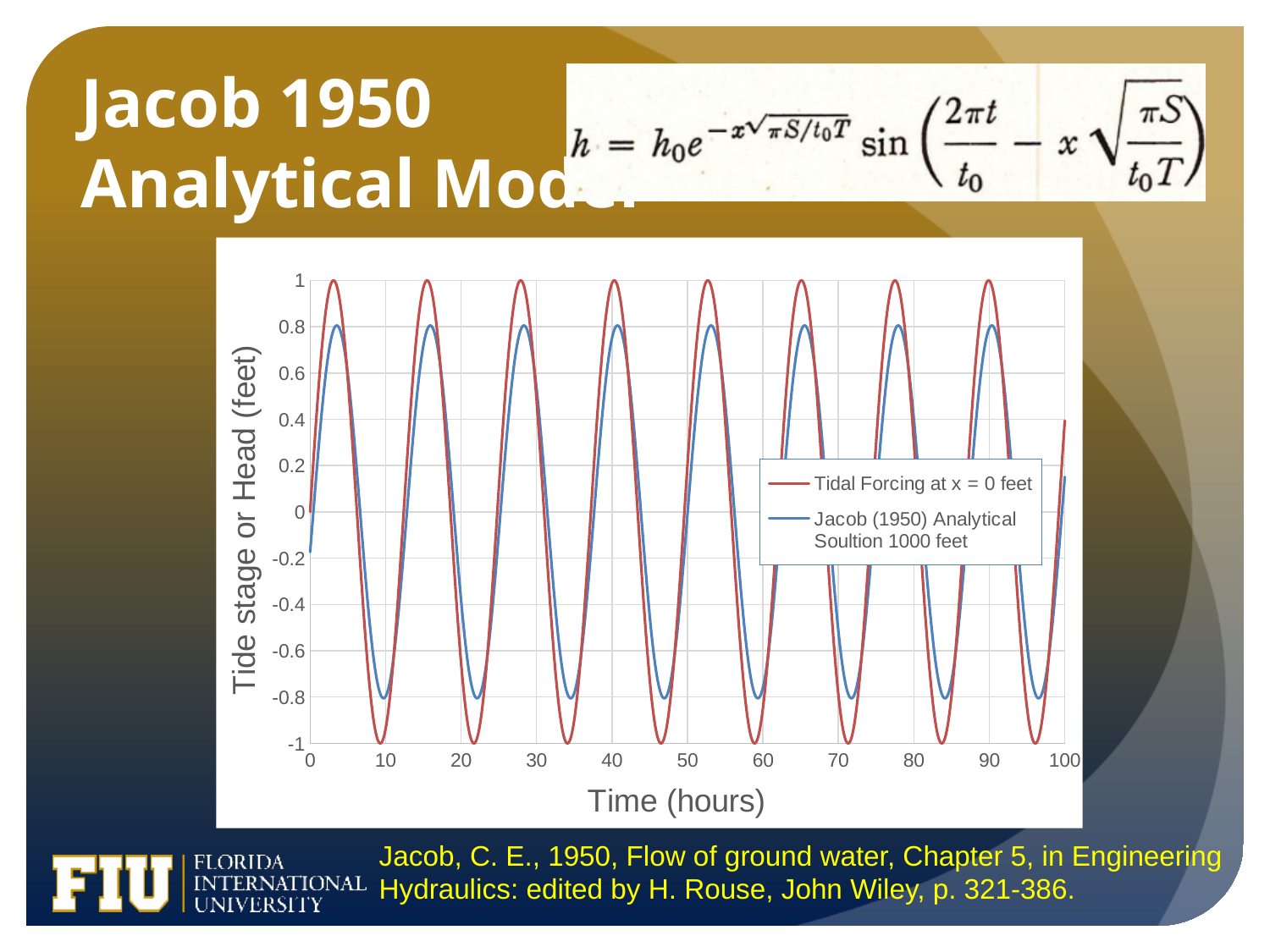
Which series reaches the highest value on the chart? Tidal Forcing at x = 0 feet What is the lowest value reached by the Tidal Forcing at x = 0 feet series? -1 Which series has the larger peak, Tidal Forcing at x = 0 feet or Jacob (1950) Analytical Soultion 1000 feet? Tidal Forcing at x = 0 feet Is the peak value of the Jacob (1950) Analytical Soultion 1000 feet series greater or less than 1? less How many series does the legend list? 2 What is the title of the x axis? Time (hours) Which series reaches the lowest value on the chart? Tidal Forcing at x = 0 feet What kind of chart is shown on the slide? line chart What colour is the line for the Tidal Forcing at x = 0 feet series? red What is the peak value reached by the Tidal Forcing at x = 0 feet series? 1